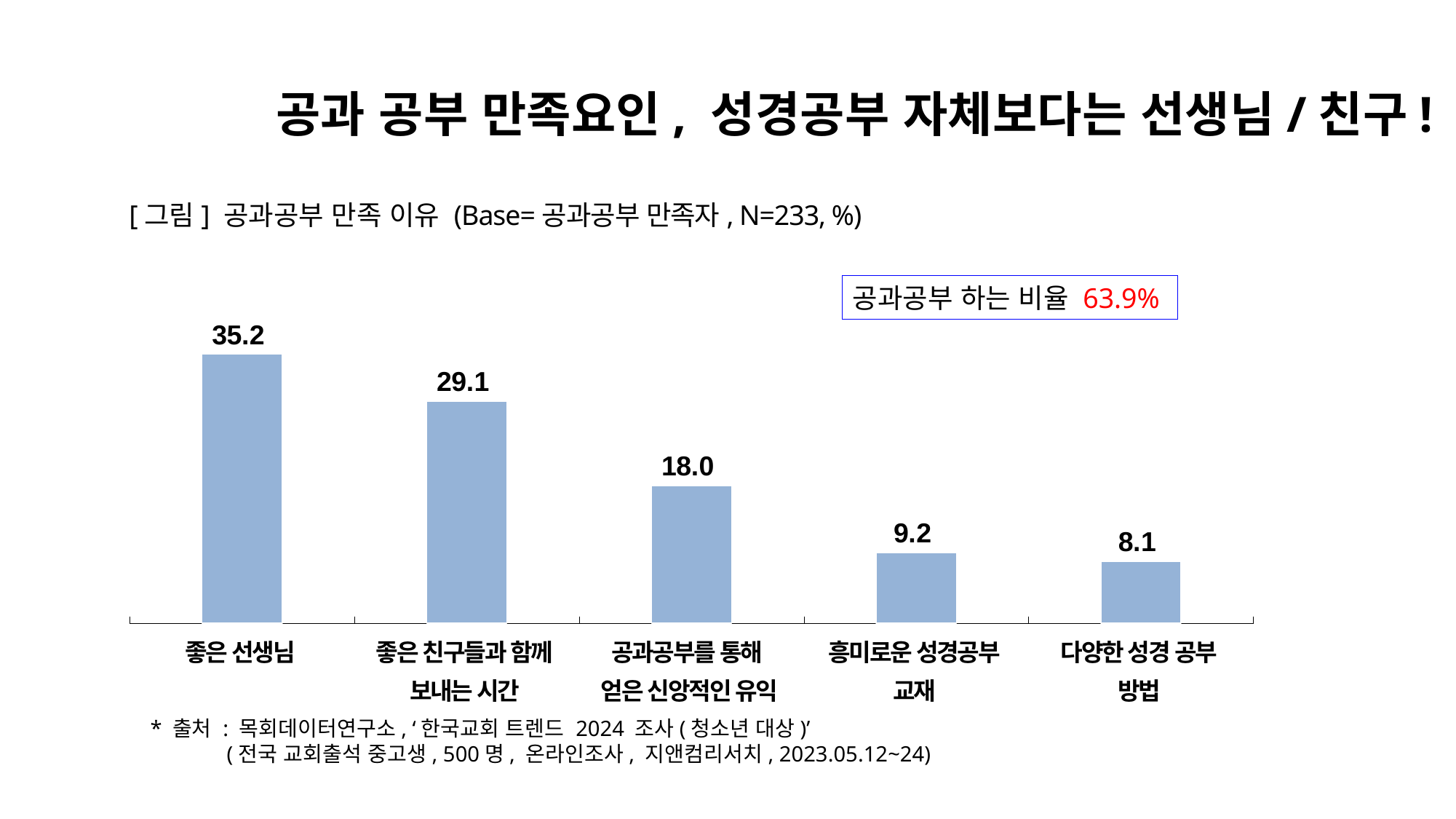
Do the values rise or fall from left to right along the x axis? fall What kind of chart is shown on the slide? bar chart Which category has the lowest value? 다양한 성경 공부 방법 What is the difference between the values for 좋은 선생님 and 좋은 친구들과 함께 보내는 시간? 6.1 Which category has the highest value? 좋은 선생님 What is the difference between the values for 흥미로운 성경공부 교재 and 다양한 성경 공부 방법? 1.1 What is the value for 다양한 성경 공부 방법? 8.1 What is the value for 좋은 친구들과 함께 보내는 시간? 29.1 Which is larger, the value for 공과공부를 통해 얻은 신앙적인 유익 or the value for 흥미로운 성경공부 교재? 공과공부를 통해 얻은 신앙적인 유익 How many categories are shown in the chart? 5 What is the value for 공과공부를 통해 얻은 신앙적인 유익? 18.0 What is the value for 좋은 선생님? 35.2